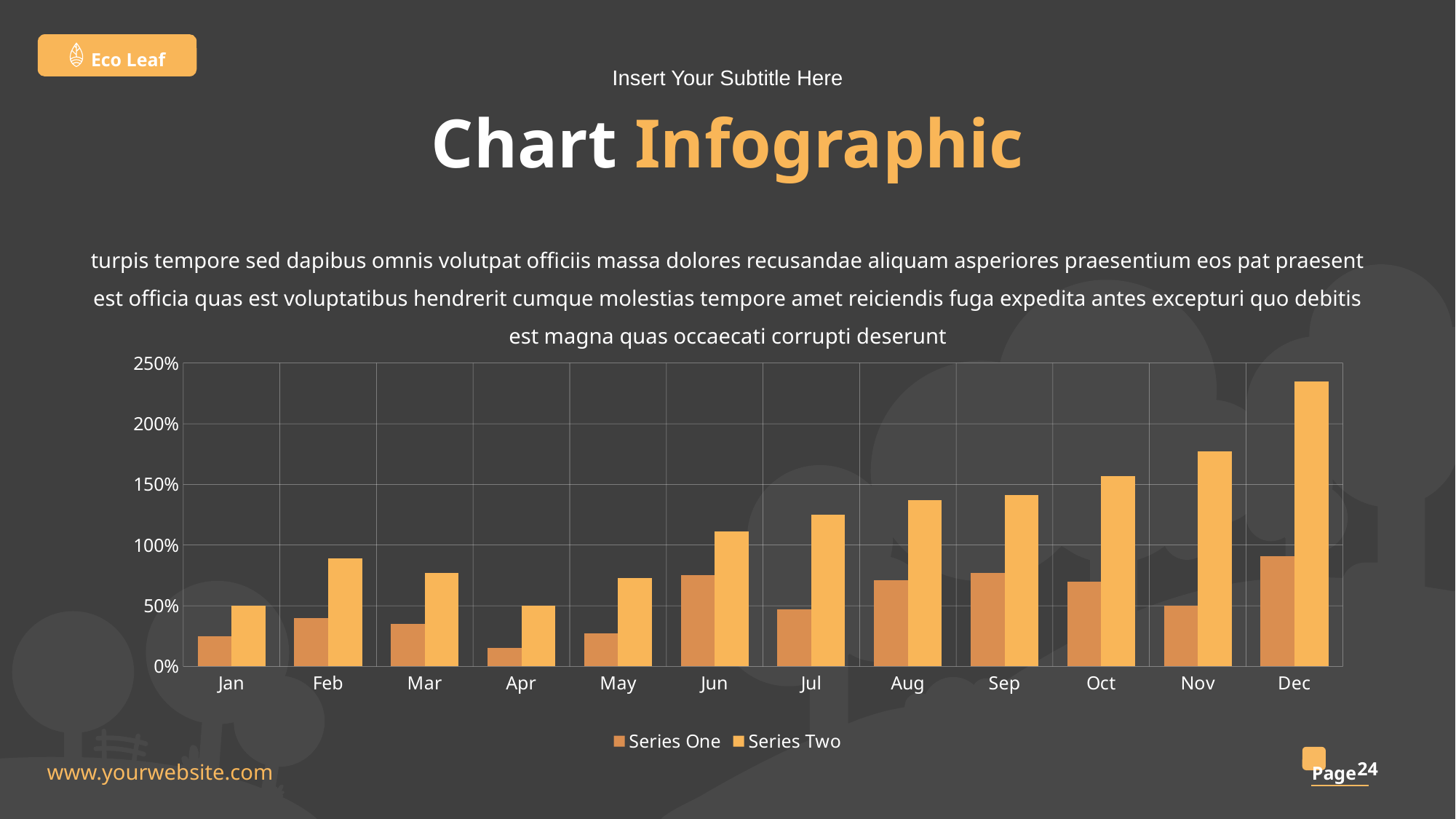
Do the Series Two values rise or fall from Jun to Dec? rise How many categories are shown on the x axis of the chart? 12 In Oct, which series has the larger value, Series One or Series Two? Series Two What are the two series named in the chart legend? Series One and Series Two Is the value for Series Two in Dec greater or less than 200%? greater How many series does the chart legend list? 2 Is the value for Series Two in Nov greater or less than 150%? greater What kind of chart is shown on the slide? bar chart Which month has the lowest value for Series One? Apr Which month has the highest value for Series Two? Dec Is the value for Series One in Jan greater or less than 50%? less Which month has the highest value for Series One? Dec